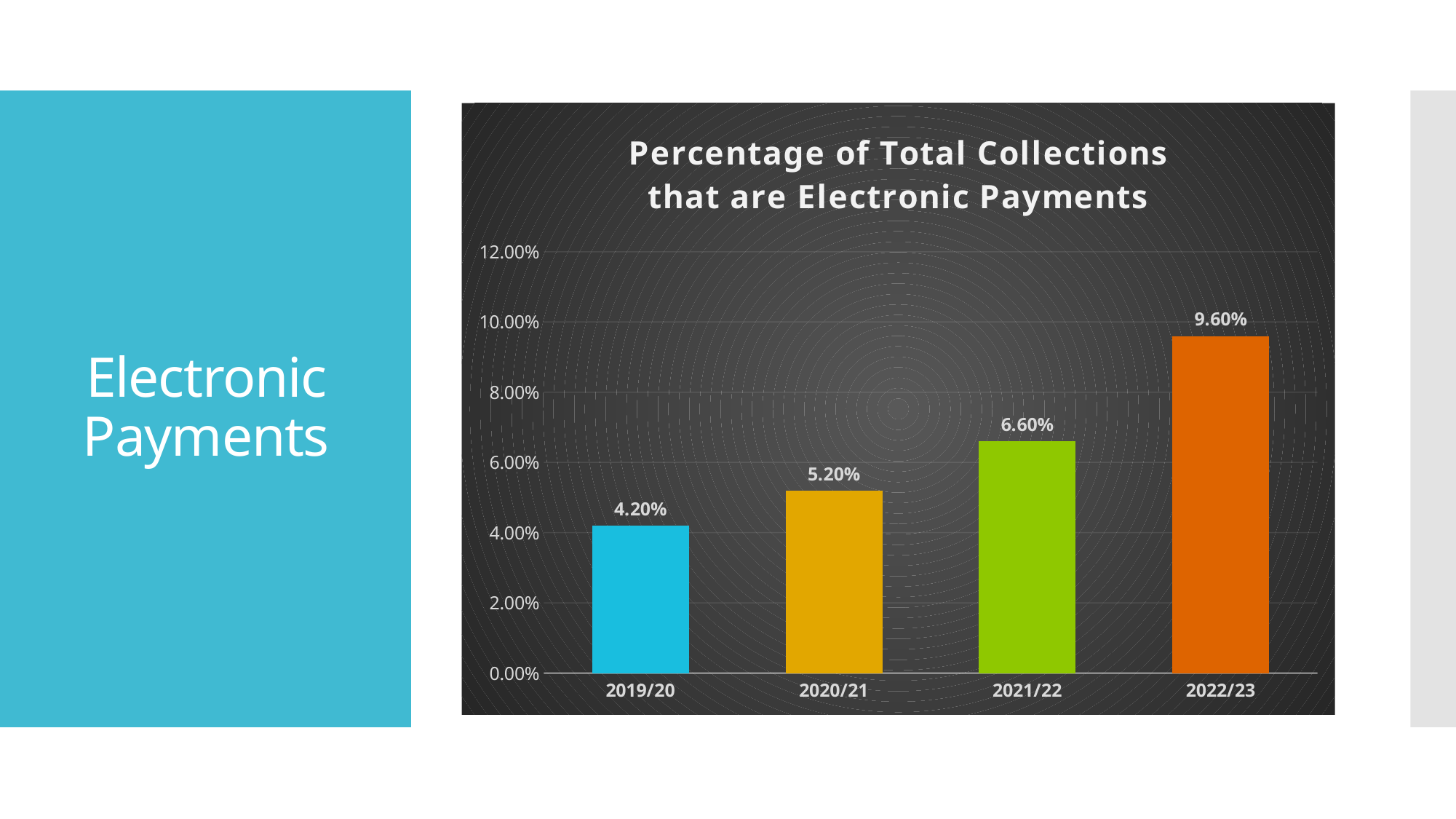
Do the values rise or fall from 2019/20 to 2022/23? Rise What is the value shown for 2021/22? 6.60% Which is larger, the value for 2020/21 or the value for 2021/22? 2021/22 What percentage of total collections were electronic payments in 2019/20? 4.20% Which year has the lowest percentage of electronic payments? 2019/20 What is the value shown for 2022/23? 9.60% What is the difference between the values for 2020/21 and 2019/20? 1.00% Is the value for 2022/23 greater or less than 8.00%? greater What kind of chart is shown on the slide? Bar chart What is the difference between the values for 2022/23 and 2021/22? 3.00% How many years are shown on the x axis? 4 Which year has the highest percentage of electronic payments? 2022/23